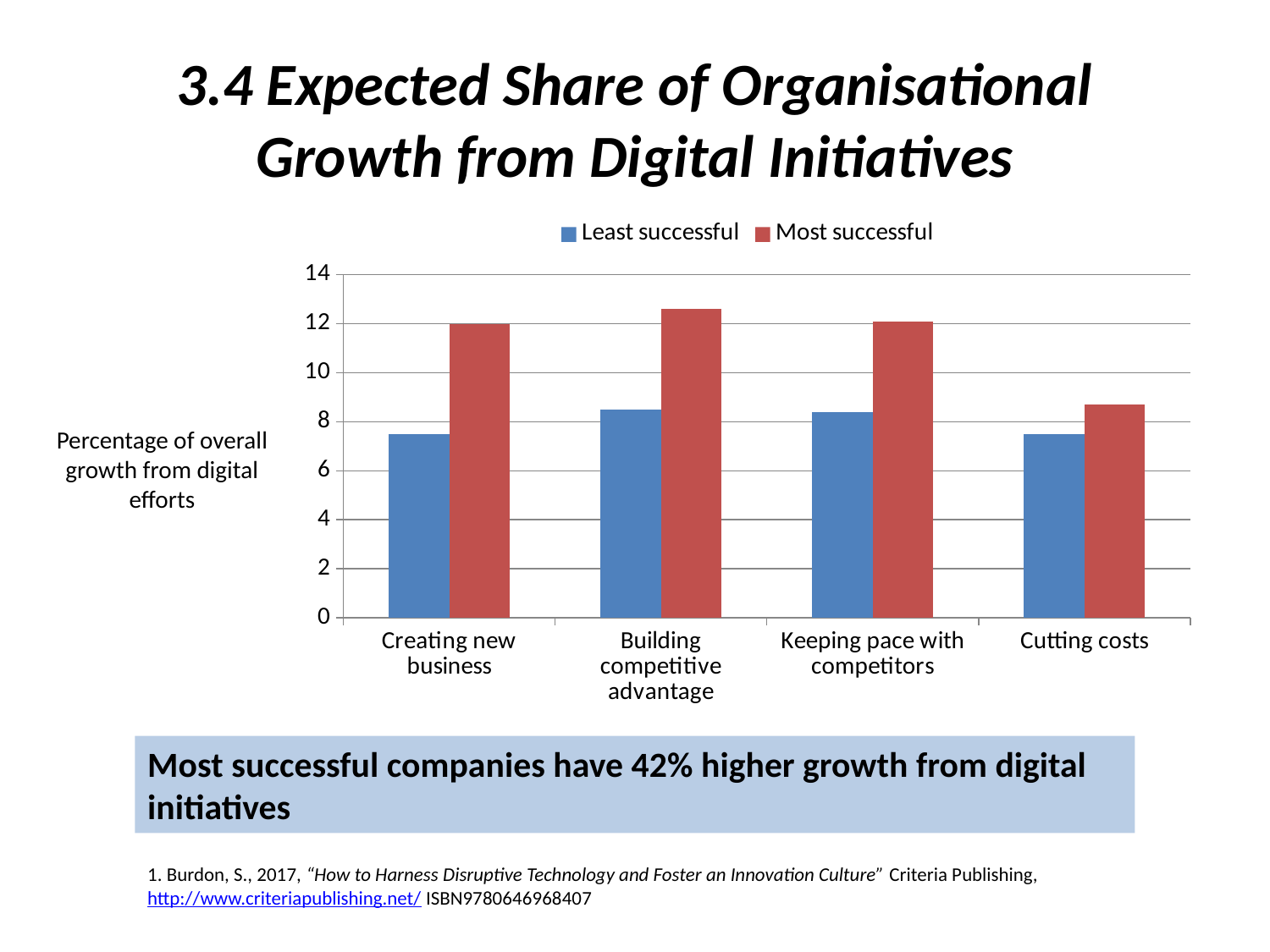
Is the Least successful value for Building competitive advantage greater or less than 8? greater Is the Most successful value for Building competitive advantage greater or less than 12? greater Which category has the highest value for the Most successful series? Building competitive advantage How many series does the legend list? 2 What is the label on the vertical axis of the chart? Percentage of overall growth from digital efforts Which is larger: the Most successful value for Cutting costs or the Most successful value for Creating new business? Creating new business Is the Least successful value for Creating new business greater or less than 8? less What kind of chart is shown on the slide? bar chart For Keeping pace with competitors, which series has the larger value, Least successful or Most successful? Most successful How many categories are shown on the x axis? 4 Which category has the lowest value for the Most successful series? Cutting costs